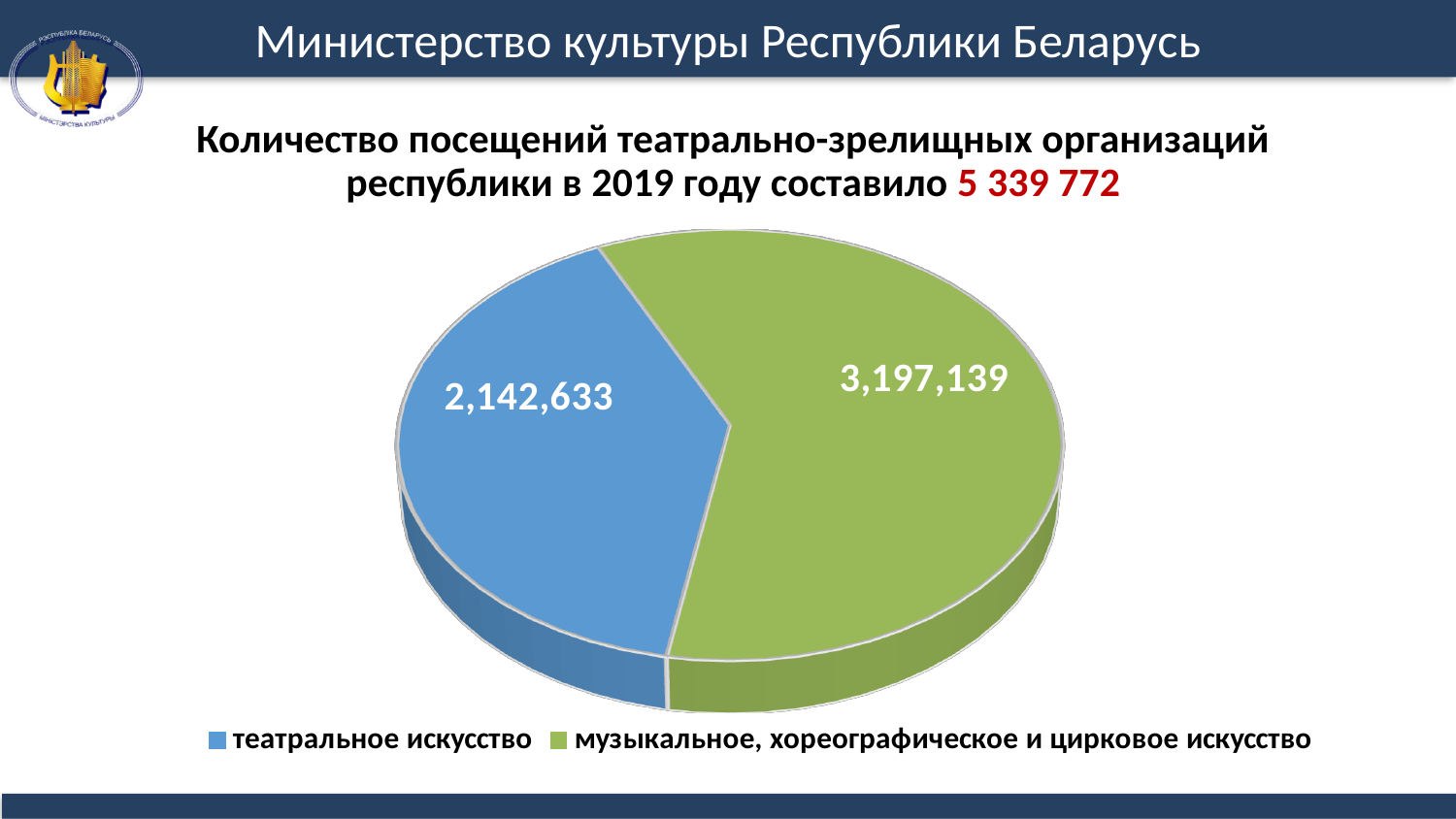
Which category has the largest slice of the pie? музыкальное, хореографическое и цирковое искусство Which is larger: the value for театральное искусство or the value for музыкальное, хореографическое и цирковое искусство? музыкальное, хореографическое и цирковое искусство What kind of chart is shown on the slide? pie chart What is the value for музыкальное, хореографическое и цирковое искусство? 3,197,139 What colour is the slice for театральное искусство? blue What is the total number of visits shown for 2019 according to the slide? 5 339 772 What is the difference between the value for музыкальное, хореографическое и цирковое искусство and the value for театральное искусство? 1,054,506 How many slices does the pie chart have? 2 How many entries does the legend list? 2 What is the value for театральное искусство? 2,142,633 Which category has the smallest slice of the pie? театральное искусство